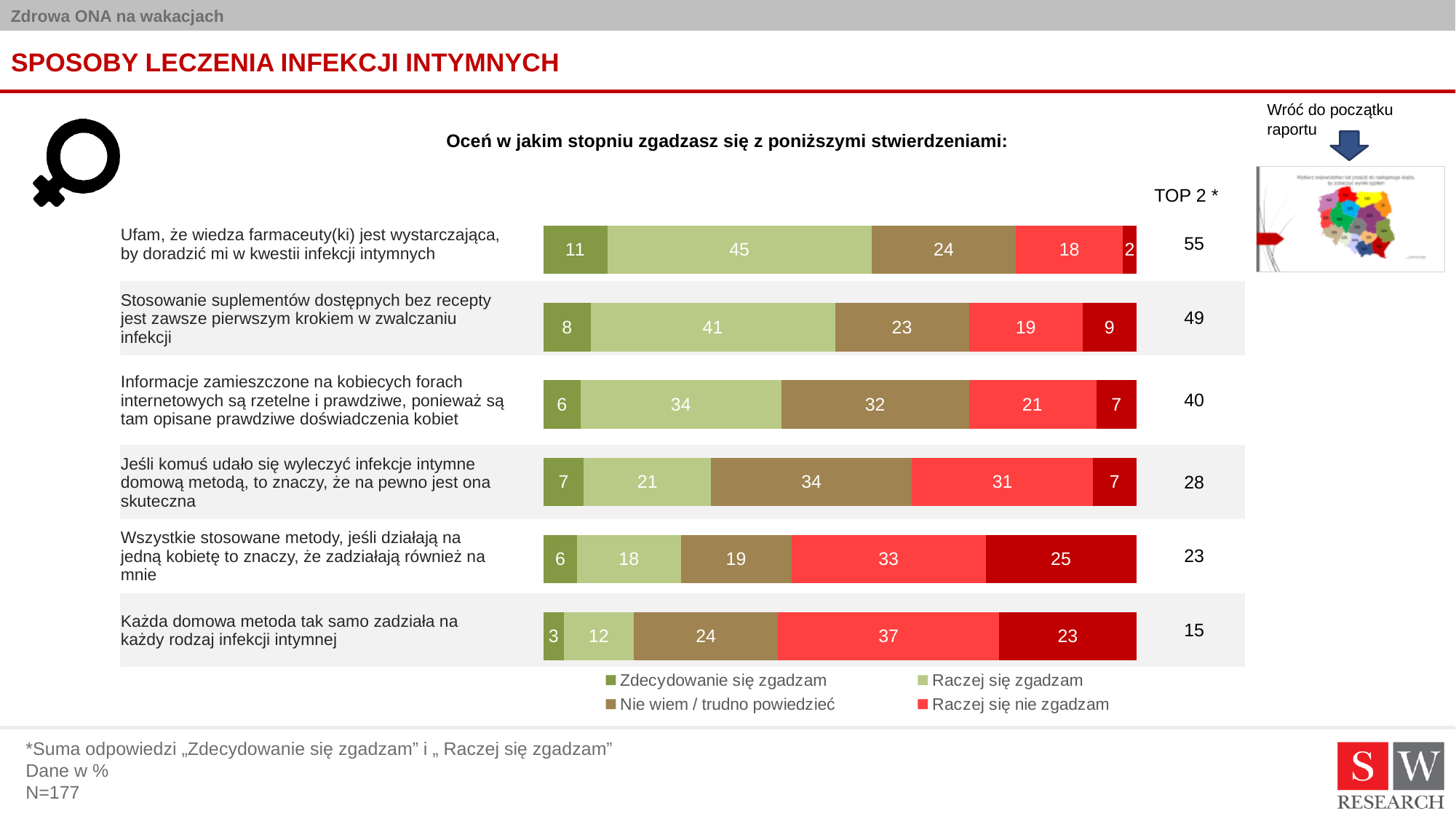
What is the 'Raczej się zgadzam' value for the statement 'Ufam, że wiedza farmaceuty(ki) jest wystarczająca, by doradzić mi w kwestii infekcji intymnych'? 45 What is the sample size (N) stated on the slide? N=177 What is the 'Nie wiem / trudno powiedzieć' value for the statement 'Jeśli komuś udało się wyleczyć infekcje intymne domową metodą, to znaczy, że na pewno jest ona skuteczna'? 34 What is the difference between the 'Raczej się nie zgadzam' values for 'Każda domowa metoda tak samo zadziała na każdy rodzaj infekcji intymnej' and 'Wszystkie stosowane metody, jeśli działają na jedną kobietę to znaczy, że zadziałają również na mnie'? 4 What is the TOP 2 value for the statement 'Stosowanie suplementów dostępnych bez recepty jest zawsze pierwszym krokiem w zwalczaniu infekcji'? 49 Which statement has the highest TOP 2 value? Ufam, że wiedza farmaceuty(ki) jest wystarczająca, by doradzić mi w kwestii infekcji intymnych How many statements (categories) are plotted in the chart? 6 How many series does the legend list? 4 Which statement has the lowest TOP 2 value? Każda domowa metoda tak samo zadziała na każdy rodzaj infekcji intymnej What is the total of the 'Zdecydowanie się zgadzam' and 'Raczej się zgadzam' segments for 'Informacje zamieszczone na kobiecych forach internetowych...'? 40 What type of chart is shown on the slide? Stacked bar chart Which is larger: the 'Zdecydowanie się zgadzam' value for 'Ufam, że wiedza farmaceuty(ki) jest wystarczająca...' or for 'Stosowanie suplementów dostępnych bez recepty...'? Ufam, że wiedza farmaceuty(ki) jest wystarczająca...